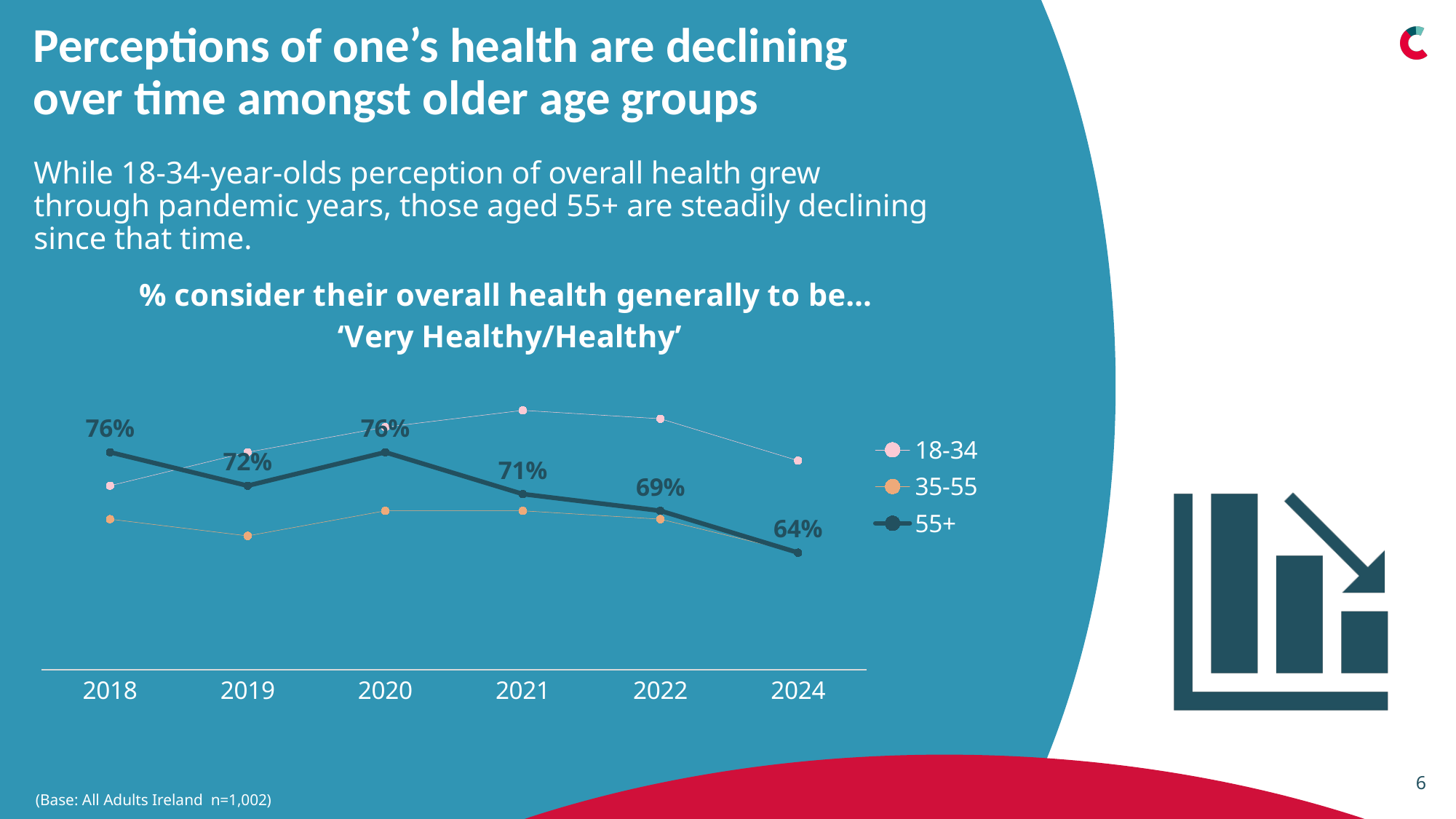
In which year is the 55+ series at its lowest value? 2024 Does the 55+ series rise or fall from 2020 to 2024? Fall What is the difference between the 55+ values in 2018 and 2024? 12 percentage points How many series does the legend list? 3 What is the value for the 55+ series in 2024? 64% What is the value for the 55+ series in 2021? 71% In 2021, which series has the higher value: 18-34 or 55+? 18-34 What is the difference between the 55+ values in 2020 and 2021? 5 percentage points How many years are shown on the x axis? 6 What kind of chart is shown on the slide? Line chart What is the value for the 55+ series in 2022? 69% What is the value for the 55+ series in 2018? 76%